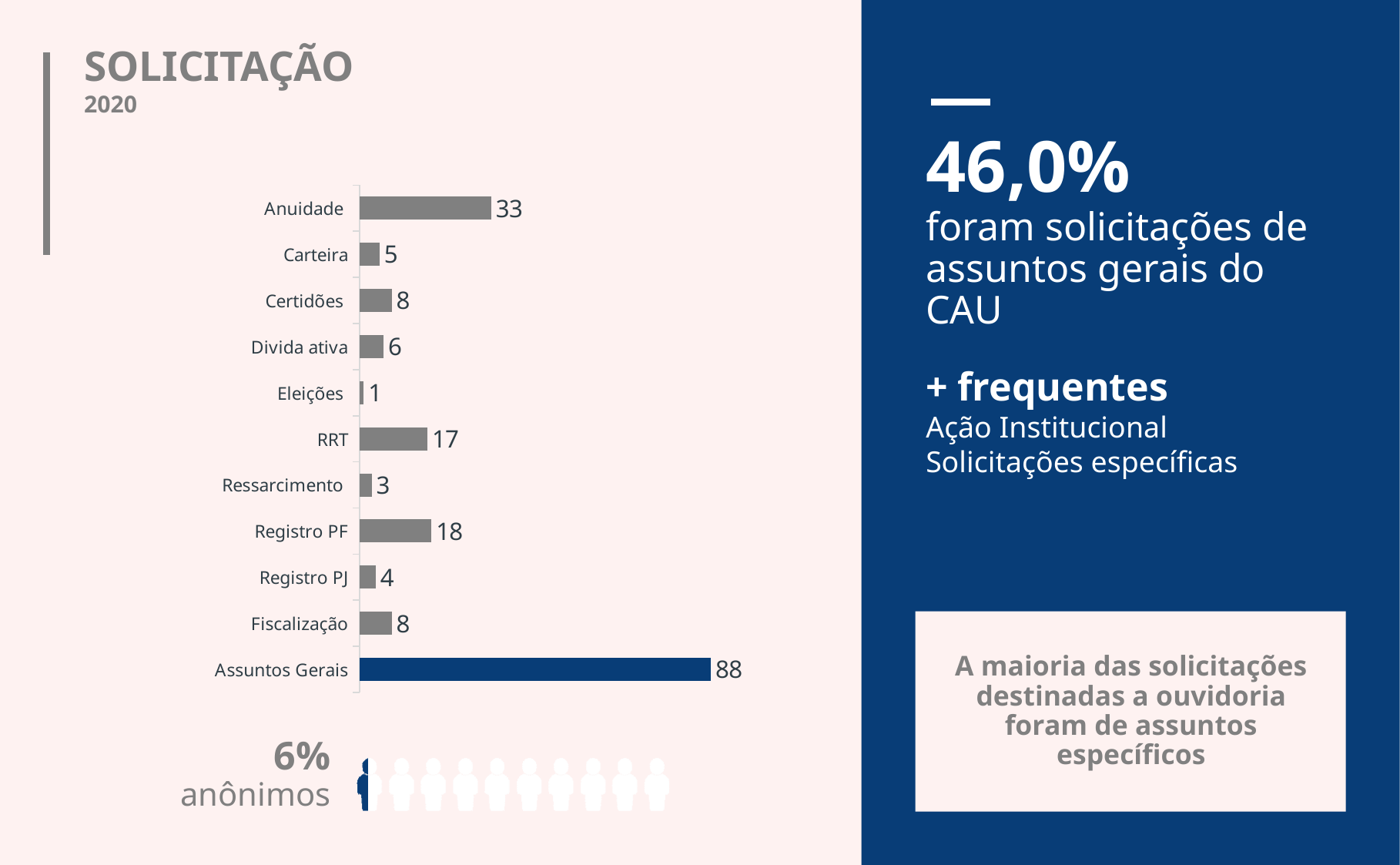
What is the value for Registro PF? 18 Which is larger, Carteira or Divida ativa? Divida ativa Which two categories both have a value of 8? Certidões and Fiscalização How many categories are shown in the chart? 11 What is the difference between Registro PF and RRT? 1 What is the value for Anuidade? 33 Which bar is coloured dark blue instead of grey? Assuntos Gerais What kind of chart is shown? bar chart What is the difference between Assuntos Gerais and Anuidade? 55 What is the value for RRT? 17 Which category has the lowest value? Eleições Which category has the highest value? Assuntos Gerais